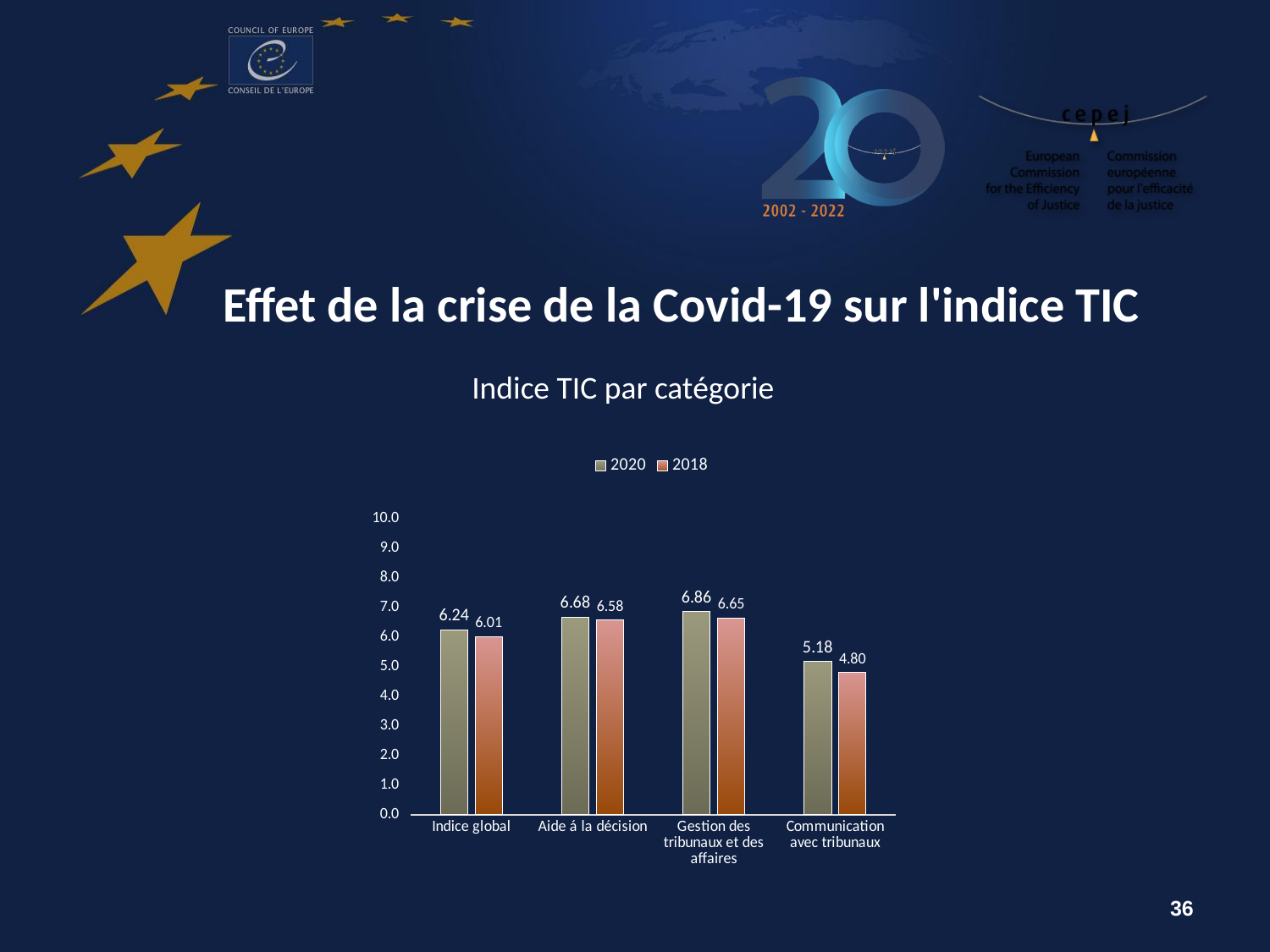
Which category has the highest 2020 value? Gestion des tribunaux et des affaires What kind of chart is shown? bar chart How many series does the legend list? 2 How many categories are shown on the x axis? 4 What is the difference between the 2020 and 2018 values for Aide á la décision? 0.10 What is the 2018 value for Communication avec tribunaux? 4.80 Which is larger for Indice global, the 2020 value or the 2018 value? 2020 Which category has the lowest 2018 value? Communication avec tribunaux Is the 2020 value for Communication avec tribunaux greater or less than 6.0? less What is the 2020 value for Indice global? 6.24 What is the 2018 value for Gestion des tribunaux et des affaires? 6.65 What is the difference between the 2020 and 2018 values for Communication avec tribunaux? 0.38